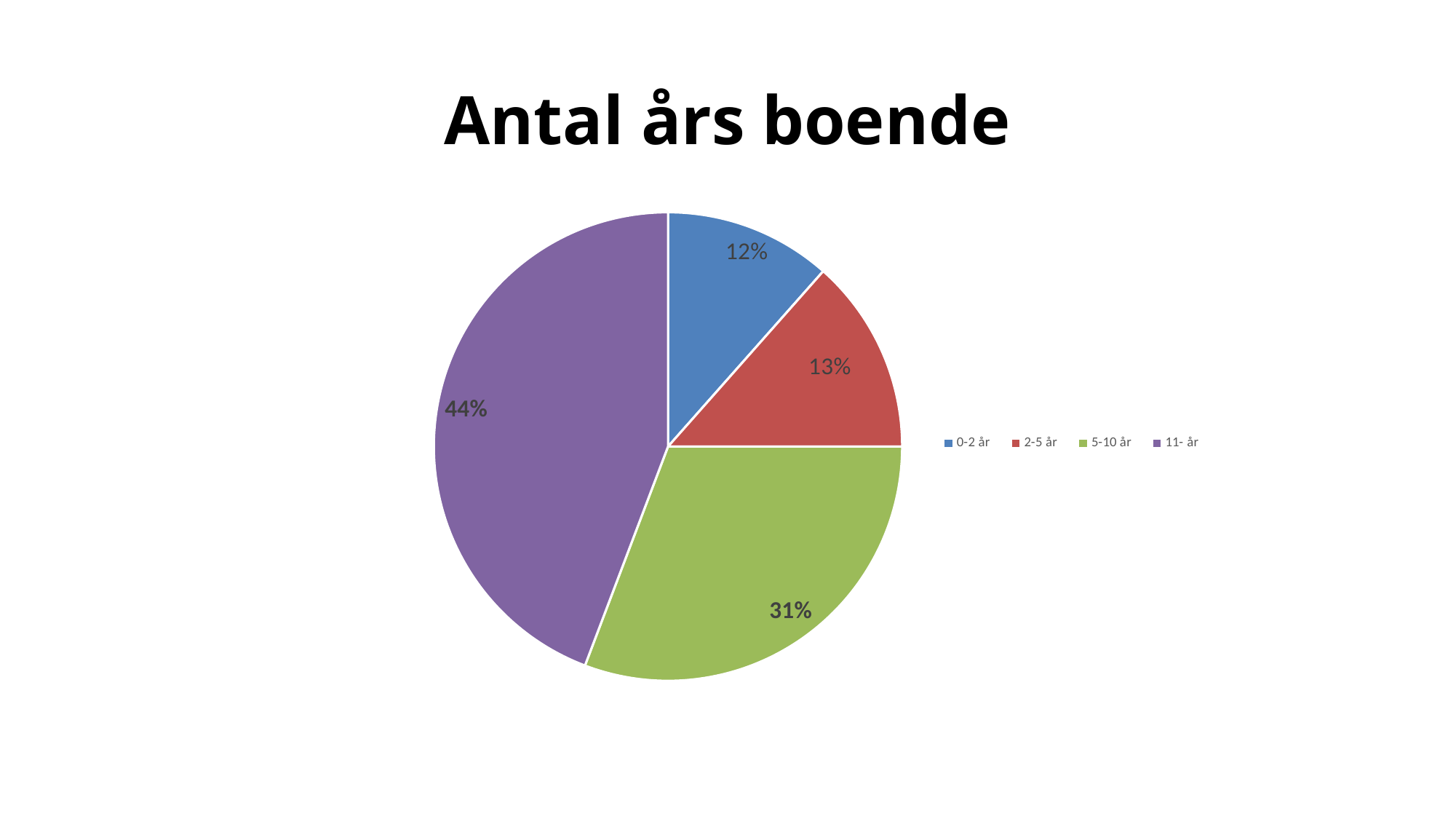
How many categories are shown in the pie chart? 4 What share of the pie does the 2-5 år slice represent? 13% Which slice is larger, 5-10 år or 2-5 år? 5-10 år Which category has the smallest share of the pie? 0-2 år What kind of chart is shown on the slide? Pie chart Which category has the largest share of the pie? 11- år What colour is the 5-10 år slice? Green What share of the pie does the 5-10 år slice represent? 31% What share of the pie does the 11- år slice represent? 44% What is the title of the chart? Antal års boende What is the difference in percentage points between the 11- år slice and the 5-10 år slice? 13